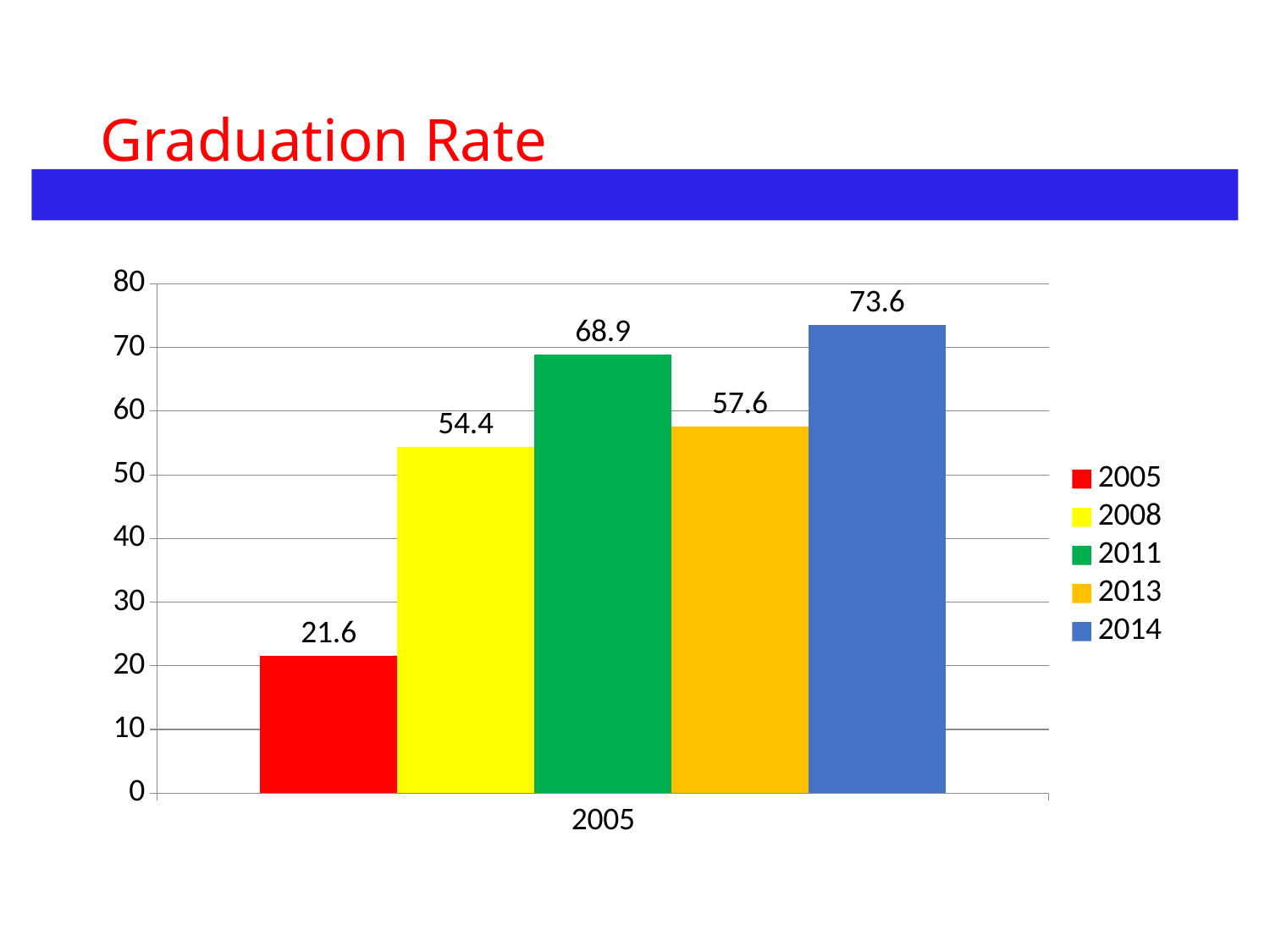
How many series does the legend list? 5 What is the graduation rate value shown for 2011? 68.9 What colour is the bar for 2011? Green Which is larger, the graduation rate for 2008 or for 2013? 2013 What is the difference between the graduation rates for 2014 and 2005? 52 What is the difference between the graduation rates for 2011 and 2013? 11.3 What kind of chart is shown on the slide? Bar chart What is the graduation rate value shown for 2013? 57.6 What is the graduation rate value shown for 2005? 21.6 What is the graduation rate value shown for 2014? 73.6 Which year has the highest graduation rate? 2014 Which year has the lowest graduation rate? 2005